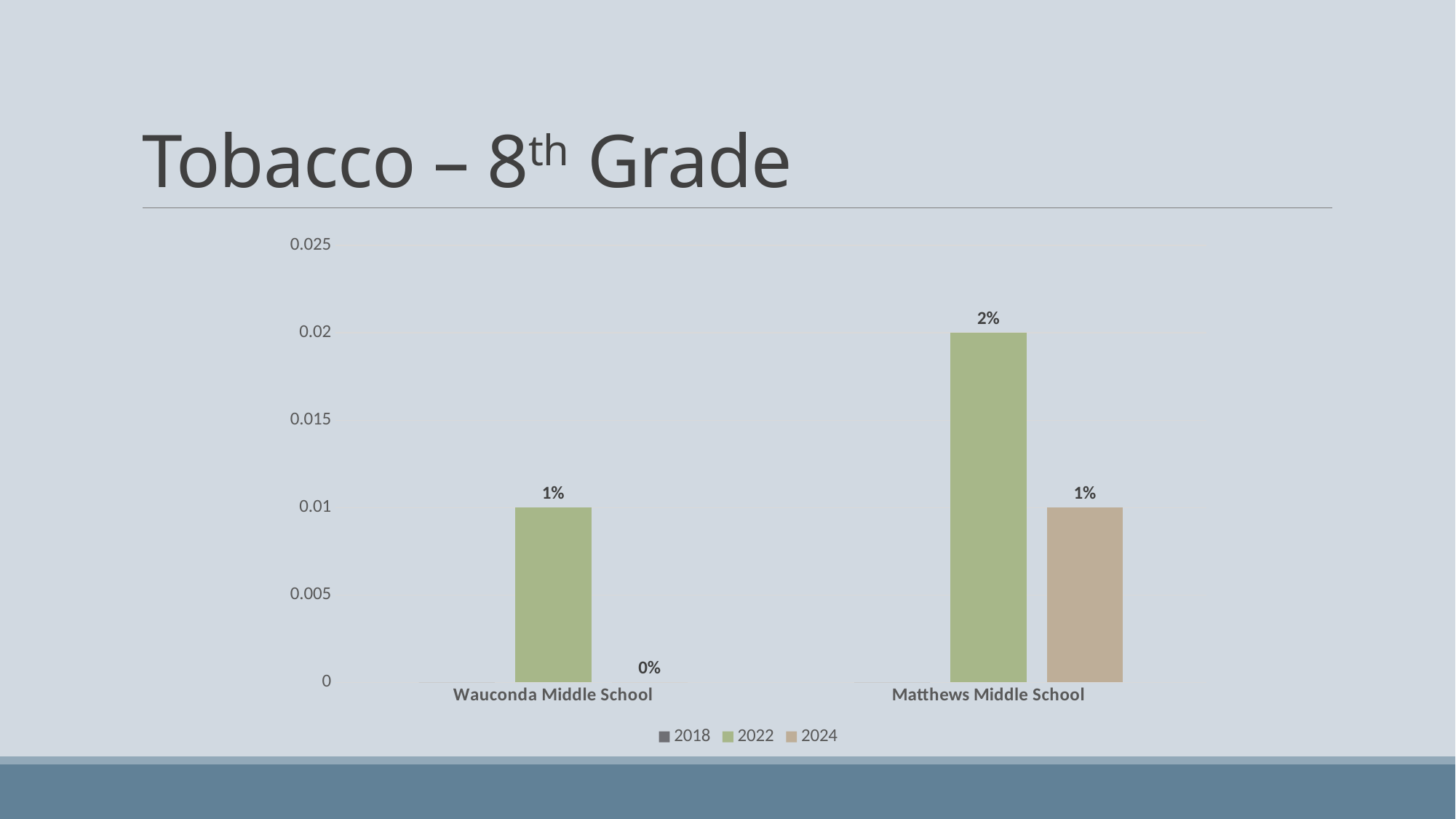
What is the title of the slide? Tobacco – 8th Grade How many schools are shown on the x axis? 2 Which school has the higher 2022 value? Matthews Middle School Which is larger: the 2024 value for Matthews Middle School or the 2024 value for Wauconda Middle School? Matthews Middle School What is the difference between the 2022 and 2024 values for Matthews Middle School? 1% What is the 2024 value for Matthews Middle School? 1% What is the difference between the 2022 values for Matthews Middle School and Wauconda Middle School? 1% What is the 2022 value for Wauconda Middle School? 1% What is the 2022 value for Matthews Middle School? 2% What kind of chart is shown on the slide? Bar chart How many series does the legend list? 3 What is the 2024 value for Wauconda Middle School? 0%